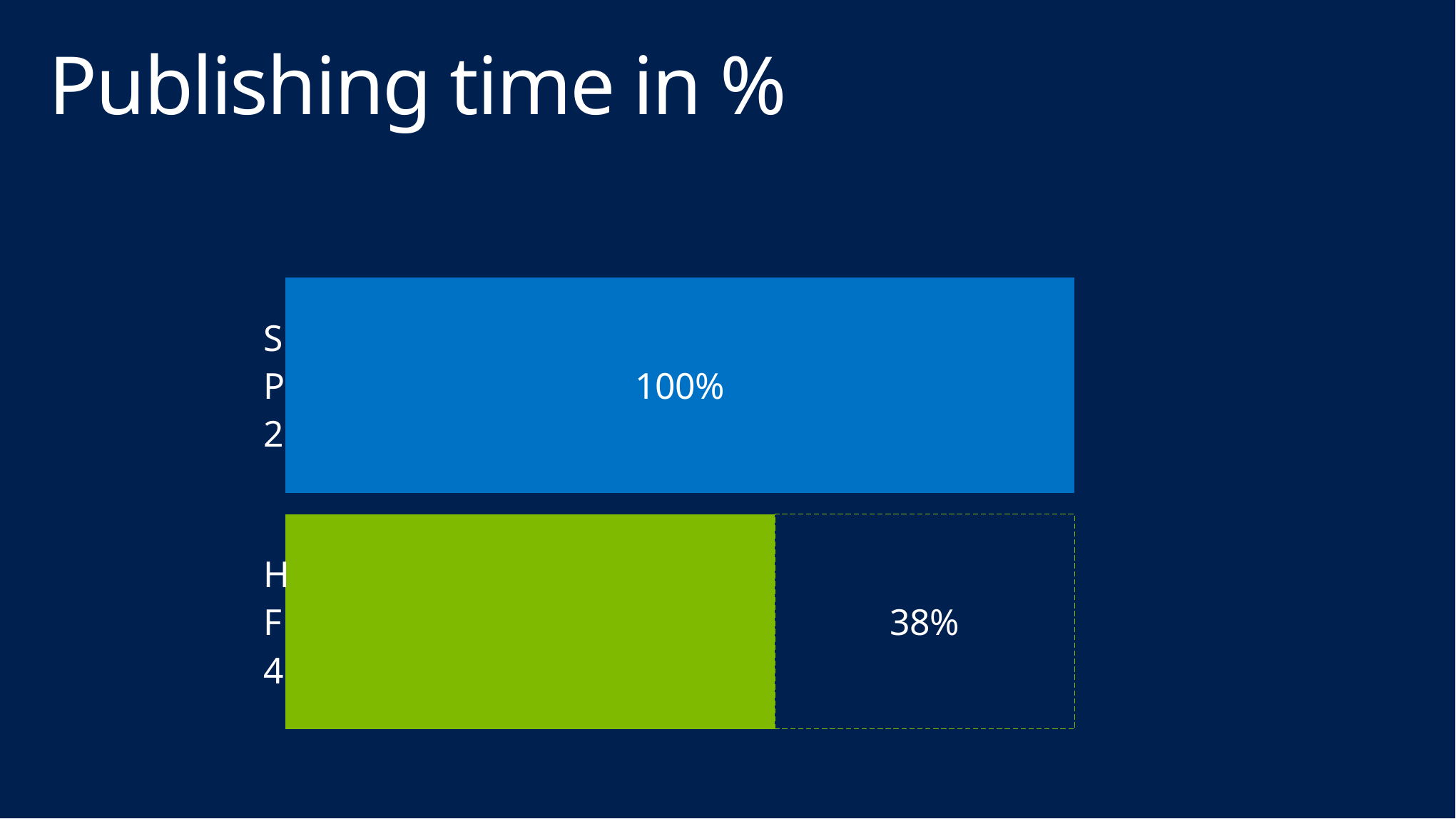
What kind of chart is shown on the slide? Bar chart What is the title of the slide? Publishing time in % Which is larger, the value for SP2 or the value for HF4? SP2 How many categories are shown in the chart? 2 Which category has the lowest publishing time? HF4 Which category has the highest publishing time? SP2 What colour is the bar for HF4? Green What is the publishing time value for SP2? 100%